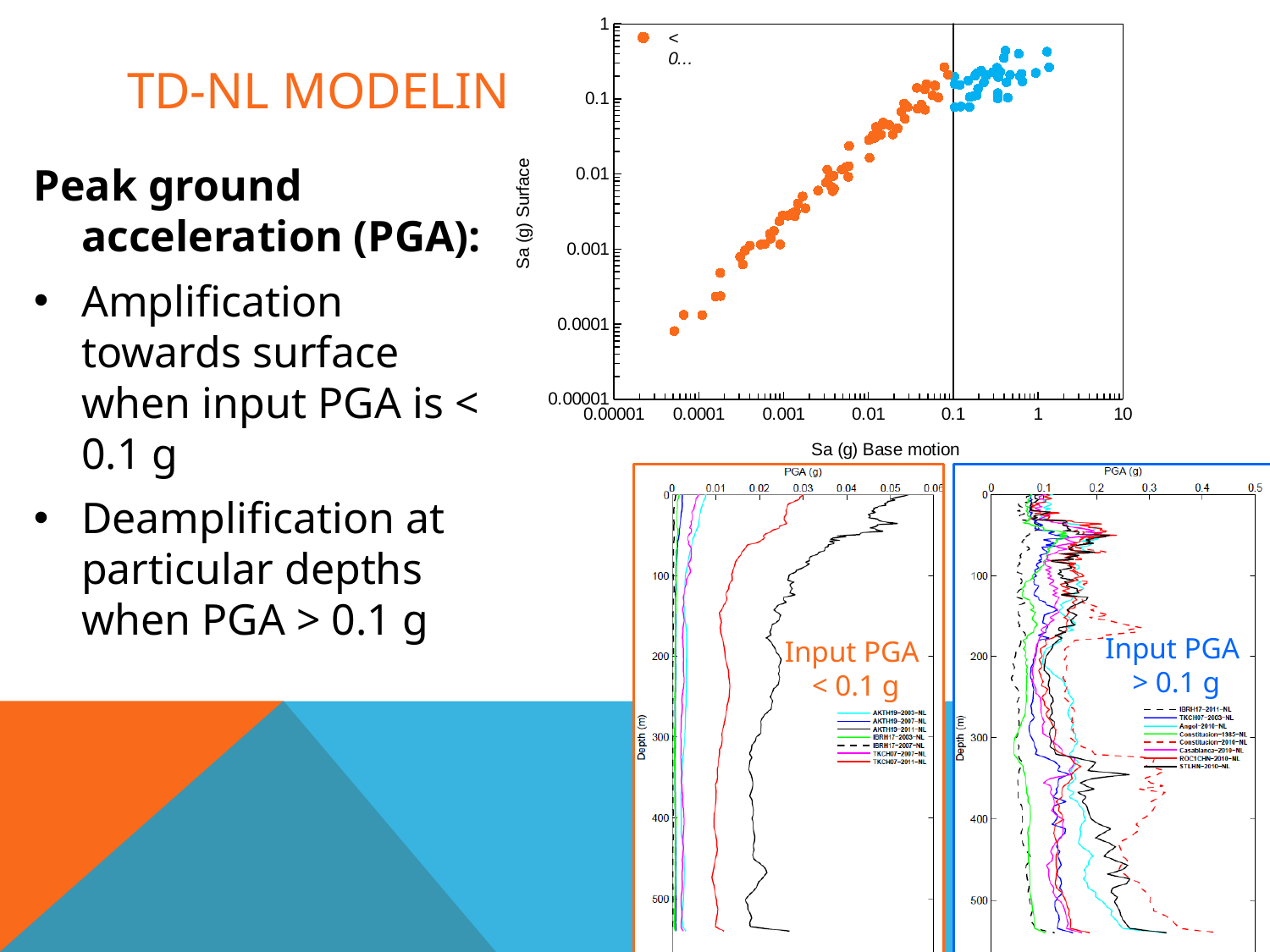
In the top-right scatter chart, are the orange points at base motion values greater or less than 0.1? less In the top-right scatter chart, are the blue points at base motion values greater or less than 0.1? greater In the top-right scatter chart, do the surface values rise or fall as base motion increases along the x axis? rise What kind of chart is the top-right chart with axes 'Sa (g) Base motion' and 'Sa (g) Surface'? scatter chart In the bottom-left depth profile chart labelled 'Input PGA < 0.1 g', what is the maximum value shown on the PGA (g) axis? 0.06 In the bottom-right depth profile chart labelled 'Input PGA > 0.1 g', what is the maximum value shown on the PGA (g) axis? 0.5 In the top-right scatter chart, at what x-axis value is the vertical reference line drawn? 0.1 In the top-right scatter chart, what is the label of the y axis? Sa (g) Surface In the top-right scatter chart, what is the highest tick value shown on the x axis? 10 In the top-right scatter chart, what is the label of the x axis? Sa (g) Base motion In the top-right scatter chart, what is the lowest tick value shown on the y axis? 0.00001 In the bottom-right depth profile chart labelled 'Input PGA > 0.1 g', how many series does the legend list? 8